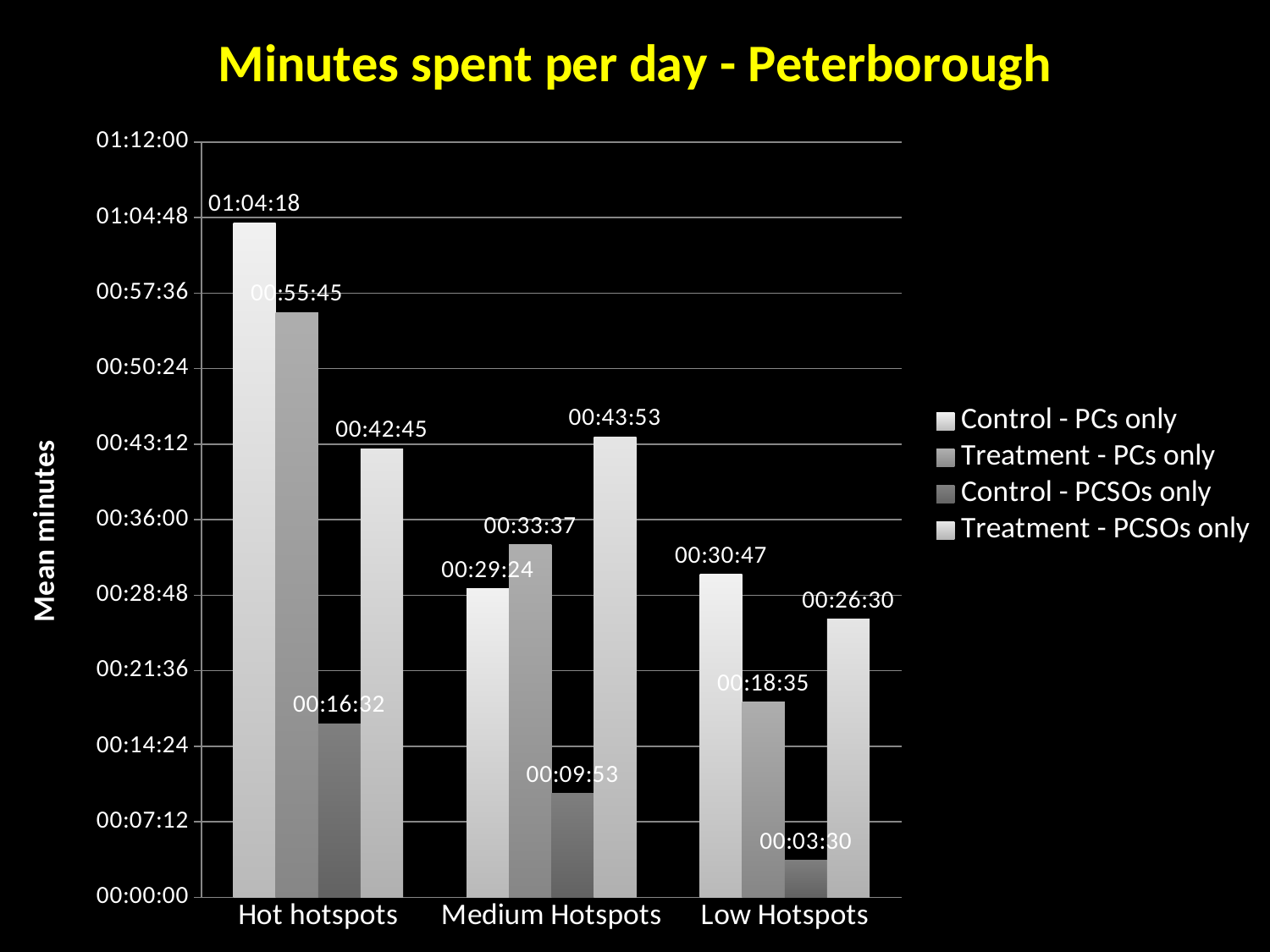
What is the value for Control - PCs only at Hot hotspots? 01:04:18 Which category has the lowest value for Treatment - PCs only? Low Hotspots At Medium Hotspots, which is larger: Control - PCs only or Treatment - PCs only? Treatment - PCs only What is the value for Treatment - PCSOs only at Medium Hotspots? 00:43:53 What is the value for Control - PCSOs only at Low Hotspots? 00:03:30 What is the value for Treatment - PCs only at Hot hotspots? 00:55:45 How many categories are shown on the x axis? 3 How many series does the legend list? 4 What kind of chart is shown? Bar chart Do the values for Control - PCSOs only rise or fall from Hot hotspots to Low Hotspots? Fall Which category has the highest value for Control - PCs only? Hot hotspots What is the title of the y axis? Mean minutes